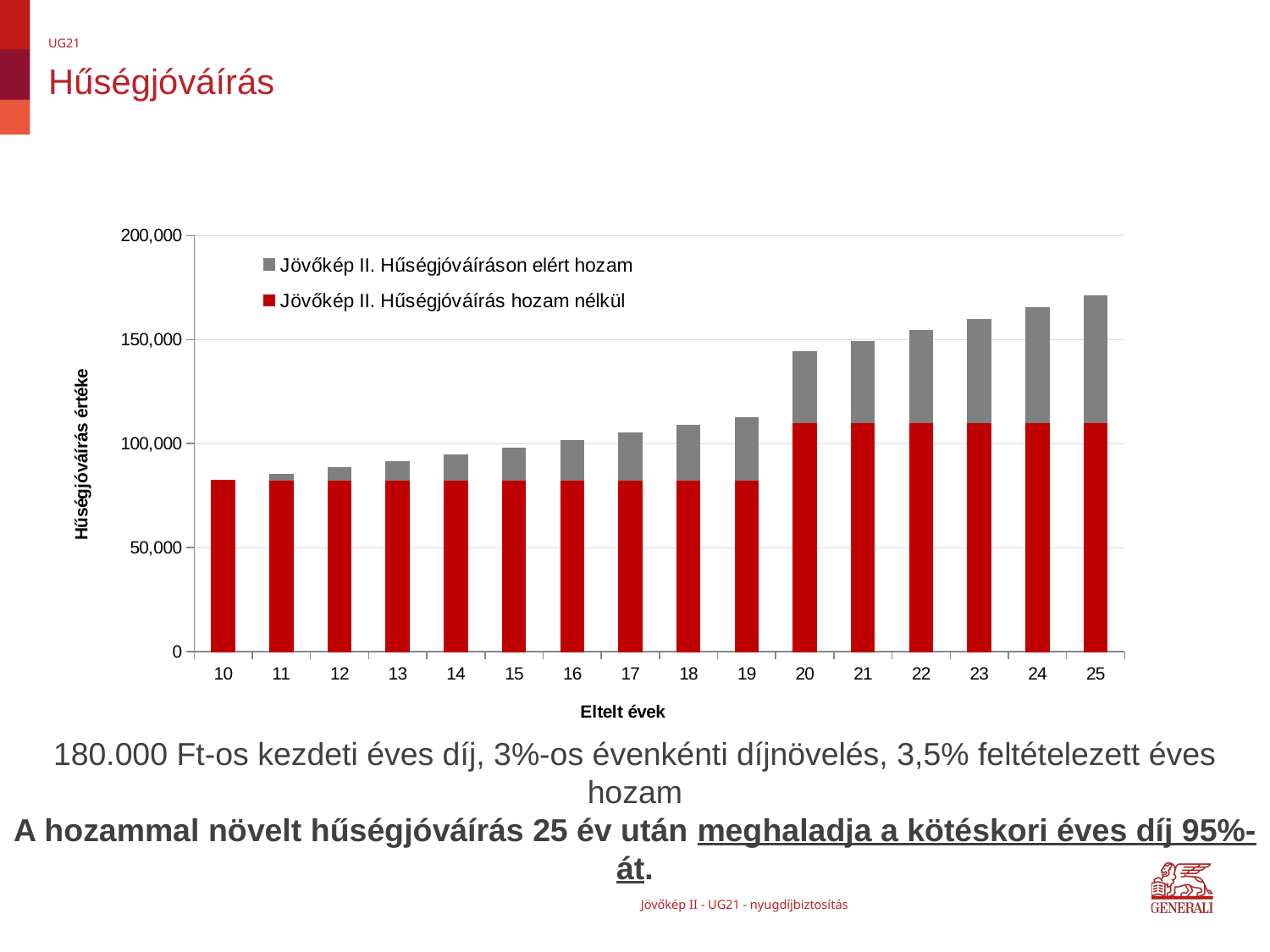
Is the total stacked value for year 20 greater or less than 150,000? less Which year has the shortest stacked bar in the chart? 10 How many categories (years) are shown on the x axis of the chart? 16 What colour represents the 'Jövőkép II. Hűségjóváírás hozam nélkül' series in the chart? red Do the total bar heights rise or fall as the years increase along the x axis? rise Which has the larger total stacked bar: year 10 or year 25? 25 Is the value of the 'Jövőkép II. Hűségjóváírás hozam nélkül' series for year 20 greater or less than 100,000? greater Is the total stacked value for year 10 greater or less than 100,000? less What kind of chart is shown on the slide? stacked bar chart Which year has the tallest stacked bar in the chart? 25 How many series does the chart legend list? 2